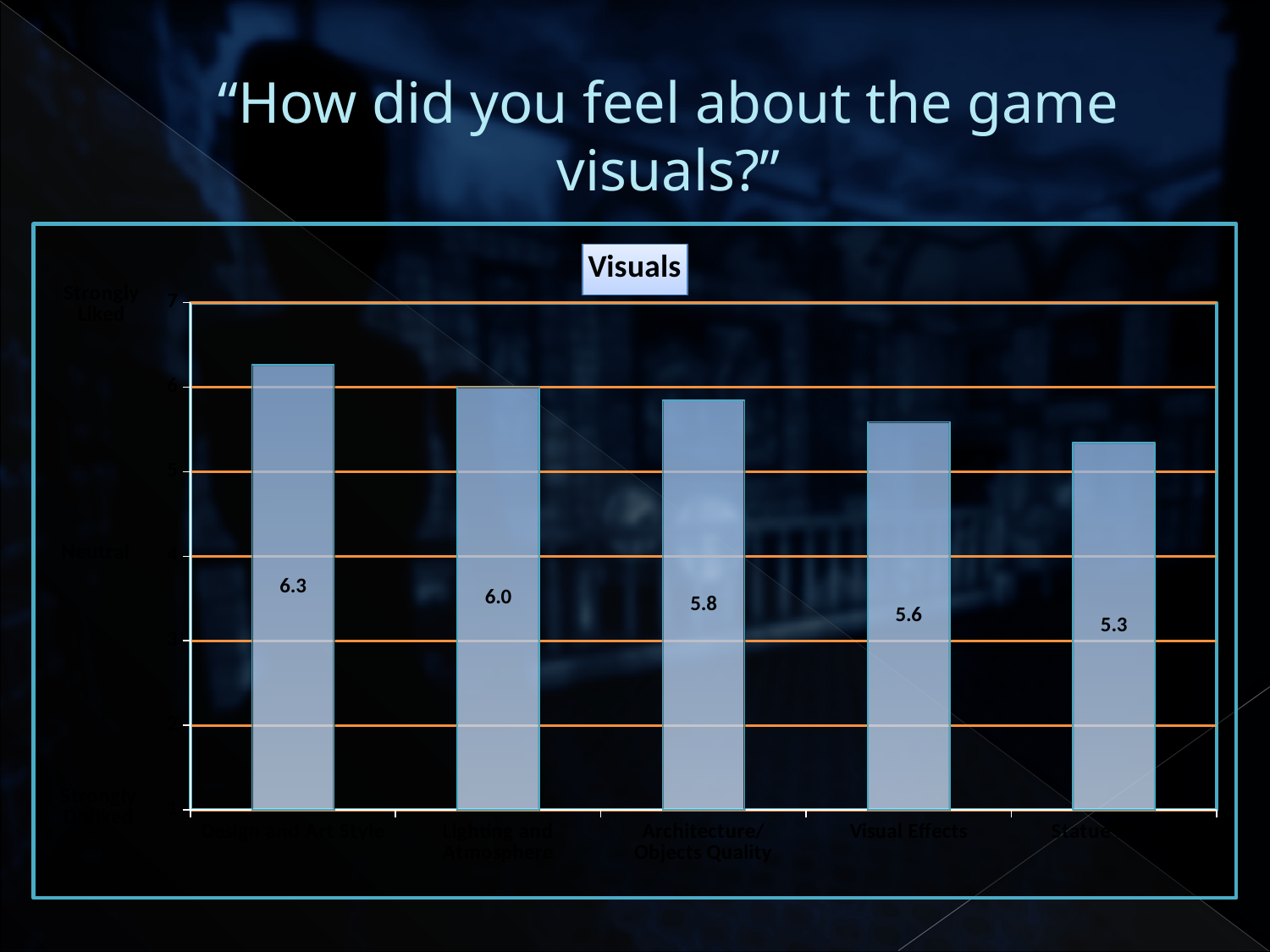
What is the value for Visual Effects? 5.6 How many categories are plotted in the Visuals chart? 5 What is the value for Lighting and Atmosphere? 6.0 Do the values rise or fall from left to right across the categories? fall Which category has the lowest value? Statue What is the value for Design and Art Style? 6.3 What is the difference between the values for Design and Art Style and Statue? 1.0 What kind of chart is shown on the slide? bar chart What is the value for Statue? 5.3 Which is larger, the value for Architecture/Objects Quality or the value for Visual Effects? Architecture/Objects Quality What is the title of the chart? Visuals Which category has the highest value? Design and Art Style